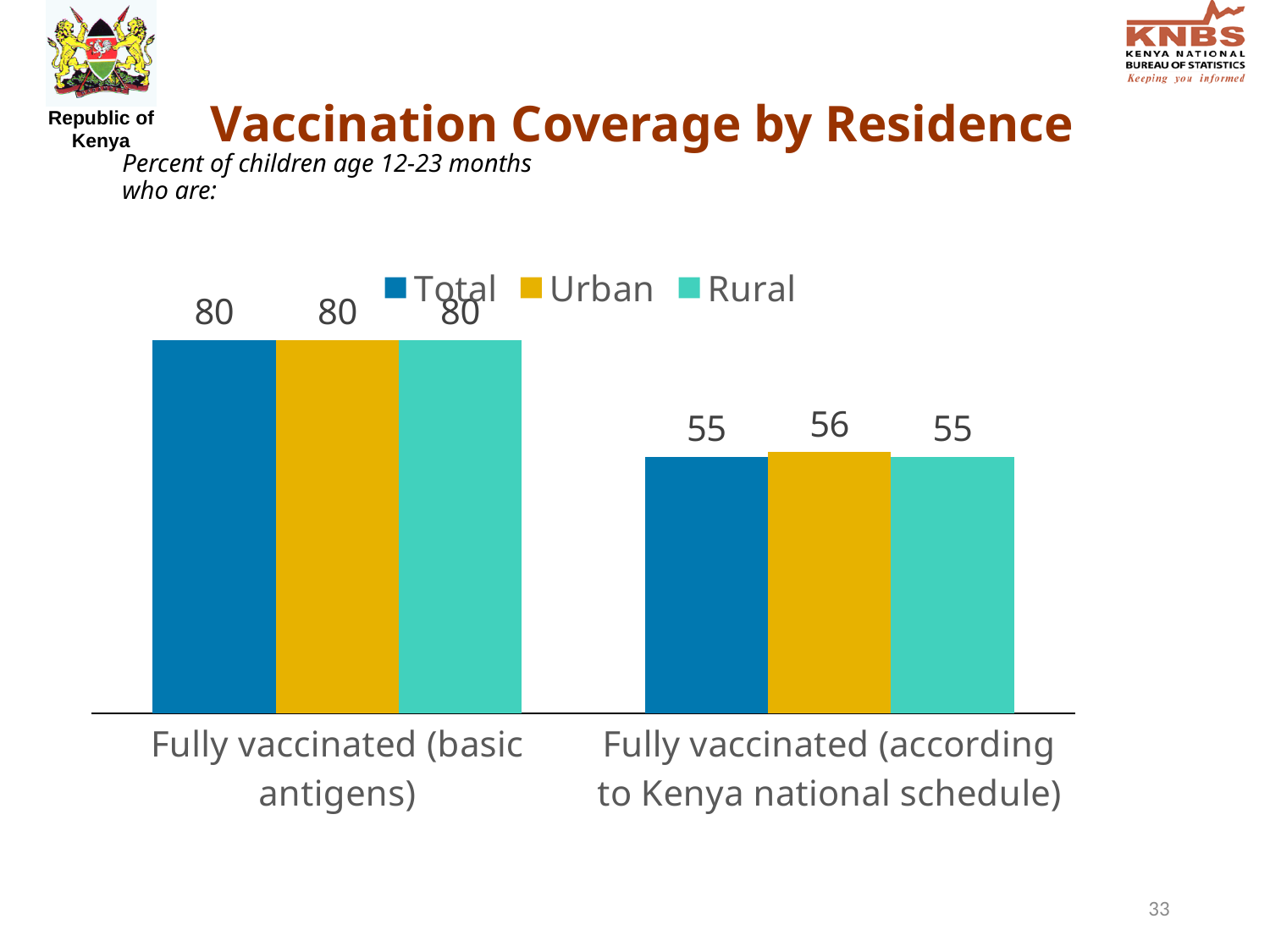
Which category has the higher Rural value, Fully vaccinated (basic antigens) or Fully vaccinated (according to Kenya national schedule)? Fully vaccinated (basic antigens) What is the Urban value for Fully vaccinated (basic antigens)? 80 What is the difference between the Total values for Fully vaccinated (basic antigens) and Fully vaccinated (according to Kenya national schedule)? 25 What is the difference between the Urban and Rural values for Fully vaccinated (according to Kenya national schedule)? 1 How many categories are shown on the x axis? 2 What kind of chart is shown on the slide? Bar chart Which series is shown in yellow? Urban What is the Rural value for Fully vaccinated (according to Kenya national schedule)? 55 What is the Total value for Fully vaccinated (basic antigens)? 80 How many series does the legend list? 3 What is the Urban value for Fully vaccinated (according to Kenya national schedule)? 56 What is the title of the chart? Vaccination Coverage by Residence